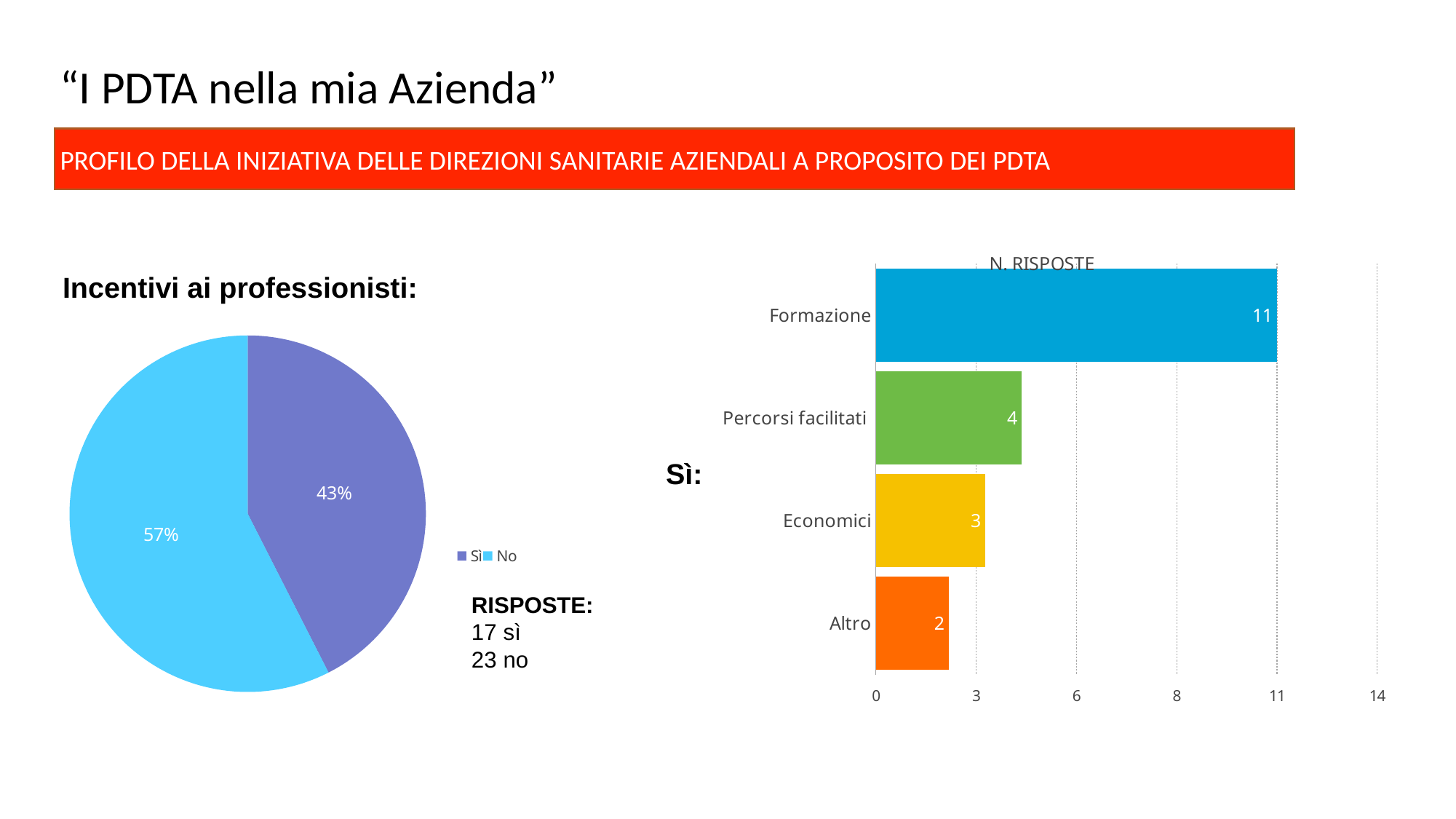
In the pie chart on the left, what percentage is shown for the 'Sì' slice? 43% In the bar chart on the right (N. RISPOSTE), how many categories are shown? 4 In the bar chart on the right (N. RISPOSTE), what is the value for 'Formazione'? 11 In the bar chart on the right (N. RISPOSTE), what is the value for 'Percorsi facilitati'? 4 What kind of chart is the chart on the left? Pie chart In the pie chart on the left, which slice is larger, 'Sì' or 'No'? No In the bar chart on the right (N. RISPOSTE), which category has the highest value? Formazione In the bar chart on the right (N. RISPOSTE), which category has the lowest value? Altro In the bar chart on the right (N. RISPOSTE), what is the difference between the values for 'Formazione' and 'Economici'? 8 In the pie chart on the left, how many slices are there? 2 What kind of chart is the chart on the right? Bar chart In the pie chart on the left, what percentage is shown for the 'No' slice? 57%